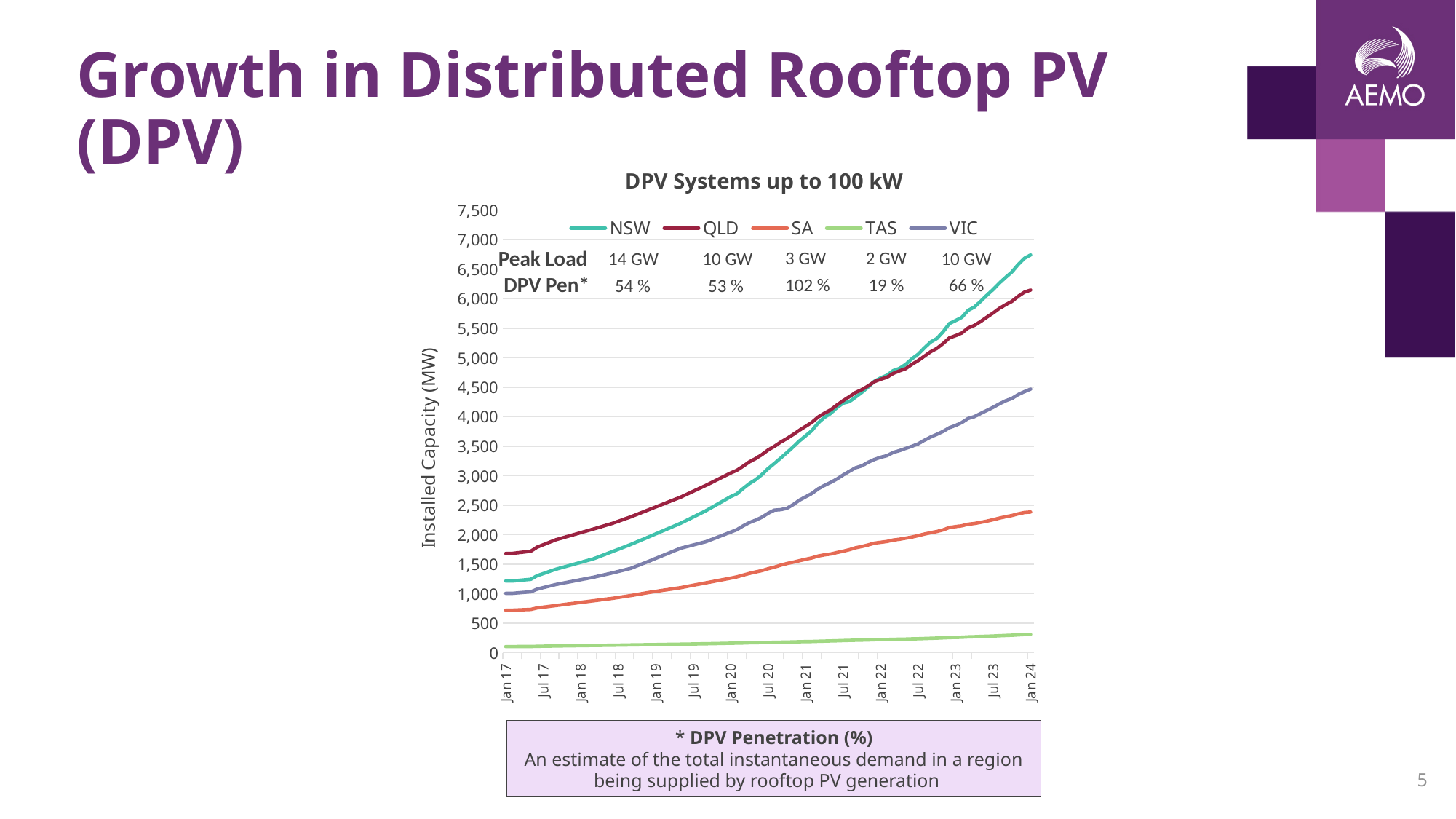
Which region has the highest DPV Pen value in the table on the chart? SA At Jan 17, which series has the larger installed capacity, QLD or NSW? QLD How many series does the legend of the chart list? 5 What kind of chart is shown on the slide? line chart What Peak Load is shown for NSW in the table on the chart? 14 GW Which series has the highest installed capacity at Jan 24? NSW Is the value for SA at Jan 24 greater or less than 2,500? less Which series has the lowest installed capacity across the whole period? TAS Is the value for VIC at Jan 24 greater or less than 4,000? greater What is the title of the chart? DPV Systems up to 100 kW What is the label of the vertical axis of the chart? Installed Capacity (MW) Does the NSW installed capacity rise or fall from Jan 17 to Jan 24? rise